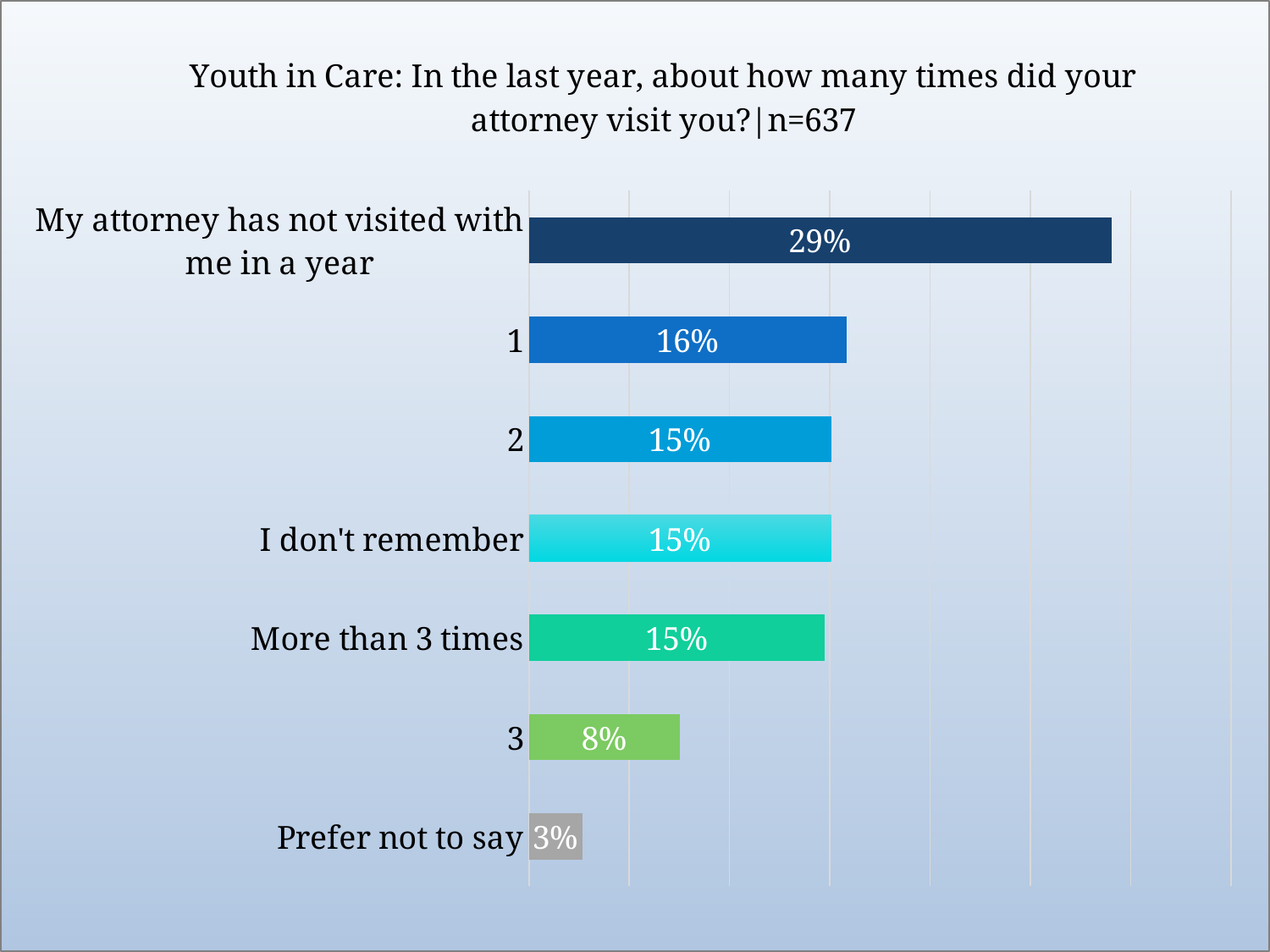
What kind of chart is shown on the slide? Bar chart Which response category has the lowest percentage? Prefer not to say How many response categories are shown in the chart? 7 What is the difference in percentage points between 'My attorney has not visited with me in a year' and '1'? 13 Which response category has the highest percentage? My attorney has not visited with me in a year What is the difference in percentage points between '3' and 'Prefer not to say'? 5 What percentage of youth said their attorney visited them 1 time? 16% What percentage of youth said their attorney visited them 3 times? 8% What percentage of youth said their attorney visited more than 3 times? 15% What percentage of youth answered 'Prefer not to say'? 3% Which is larger, the percentage for '1' or the percentage for '3'? 1 What percentage of youth said their attorney has not visited with them in a year? 29%